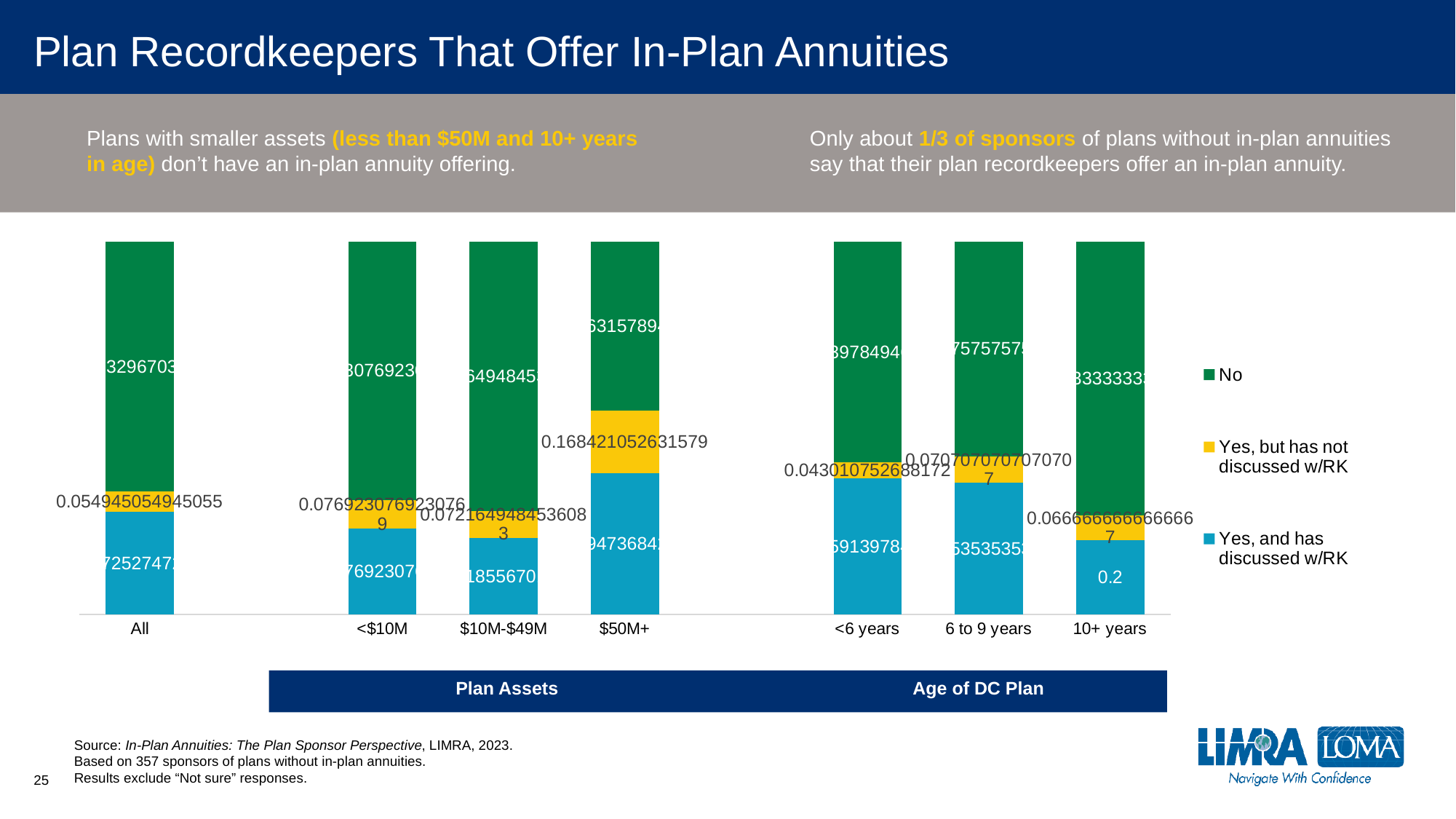
What is the value of 'Yes, and has discussed w/RK' for the 10+ years category? 0.2 What is the value of 'Yes, but has not discussed w/RK' for the $50M+ category? 0.168421052631579 Which category has the lowest value for 'Yes, but has not discussed w/RK'? <6 years Which category has the highest value for 'Yes, but has not discussed w/RK'? $50M+ What are the two group labels shown beneath the x axis? Plan Assets and Age of DC Plan What colour represents the 'No' series in the legend? Green What is the value of 'Yes, but has not discussed w/RK' for the <6 years category? 0.043010752688172 Which is larger for 'Yes, and has discussed w/RK': $50M+ or 10+ years? $50M+ What kind of chart is shown on the slide? Stacked bar chart How many categories are shown along the x axis? 7 What is the value of 'Yes, but has not discussed w/RK' for the All category? 0.054945054945055 How many series does the legend list? 3